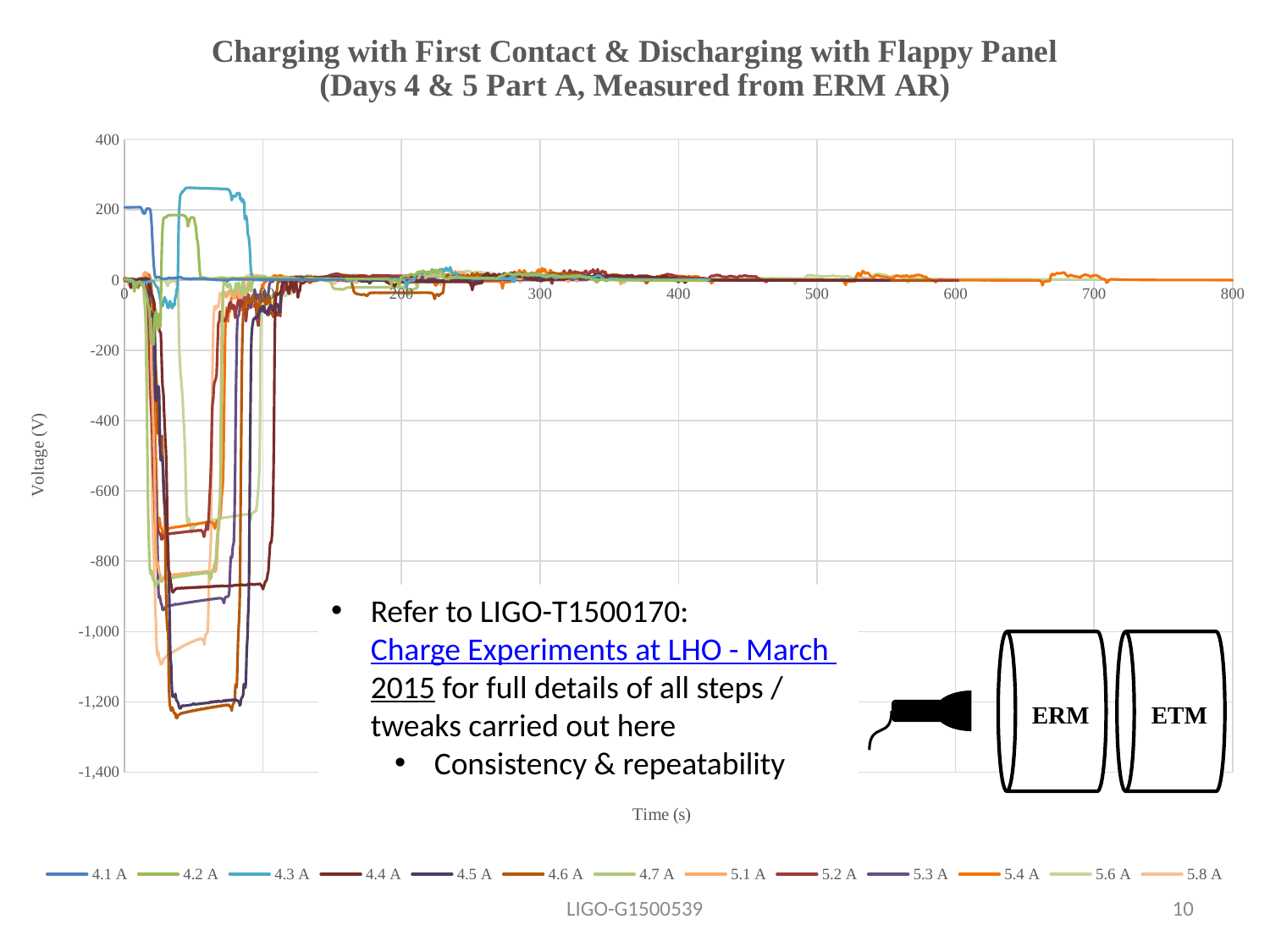
What is the label of the vertical axis? Voltage (V) Is the peak value of the 4.3 A series greater or less than 200? greater After about 400 s on the x axis, do the plotted voltages stay near 0 or swing widely? stay near 0 How many series does the legend list? 13 Do the large negative voltage excursions occur early or late along the time axis? early What is the title of the chart? Charging with First Contact & Discharging with Flappy Panel (Days 4 & 5 Part A, Measured from ERM AR) Is the lowest voltage plotted on the chart greater or less than -1,200? less Is the lowest voltage plotted on the chart greater or less than -1,400? greater What kind of chart is shown on the slide? line chart